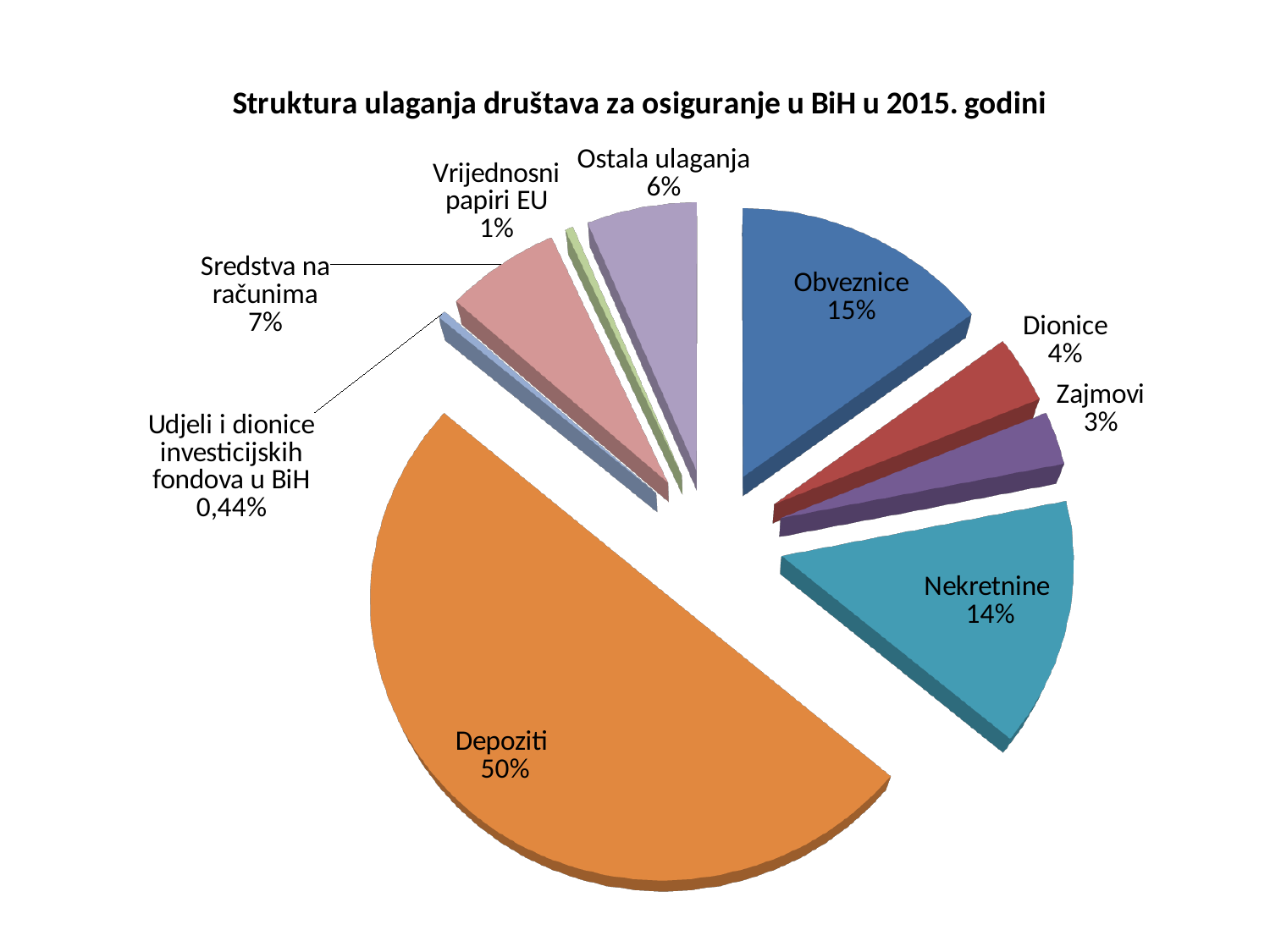
What share of the pie does Depoziti hold? 50% What is the value shown for Nekretnine? 14% Which category has the smallest slice? Udjeli i dionice investicijskih fondova u BiH How many categories are shown in the pie chart? 9 What is the value shown for Obveznice? 15% What is the value shown for Sredstva na računima? 7% Which category has the largest slice? Depoziti What kind of chart is shown on the slide? Pie chart Which is larger, Dionice or Zajmovi? Dionice What is the title of the chart? Struktura ulaganja društava za osiguranje u BiH u 2015. godini What is the value shown for Udjeli i dionice investicijskih fondova u BiH? 0,44% What is the difference between the Obveznice and Nekretnine shares? 1%